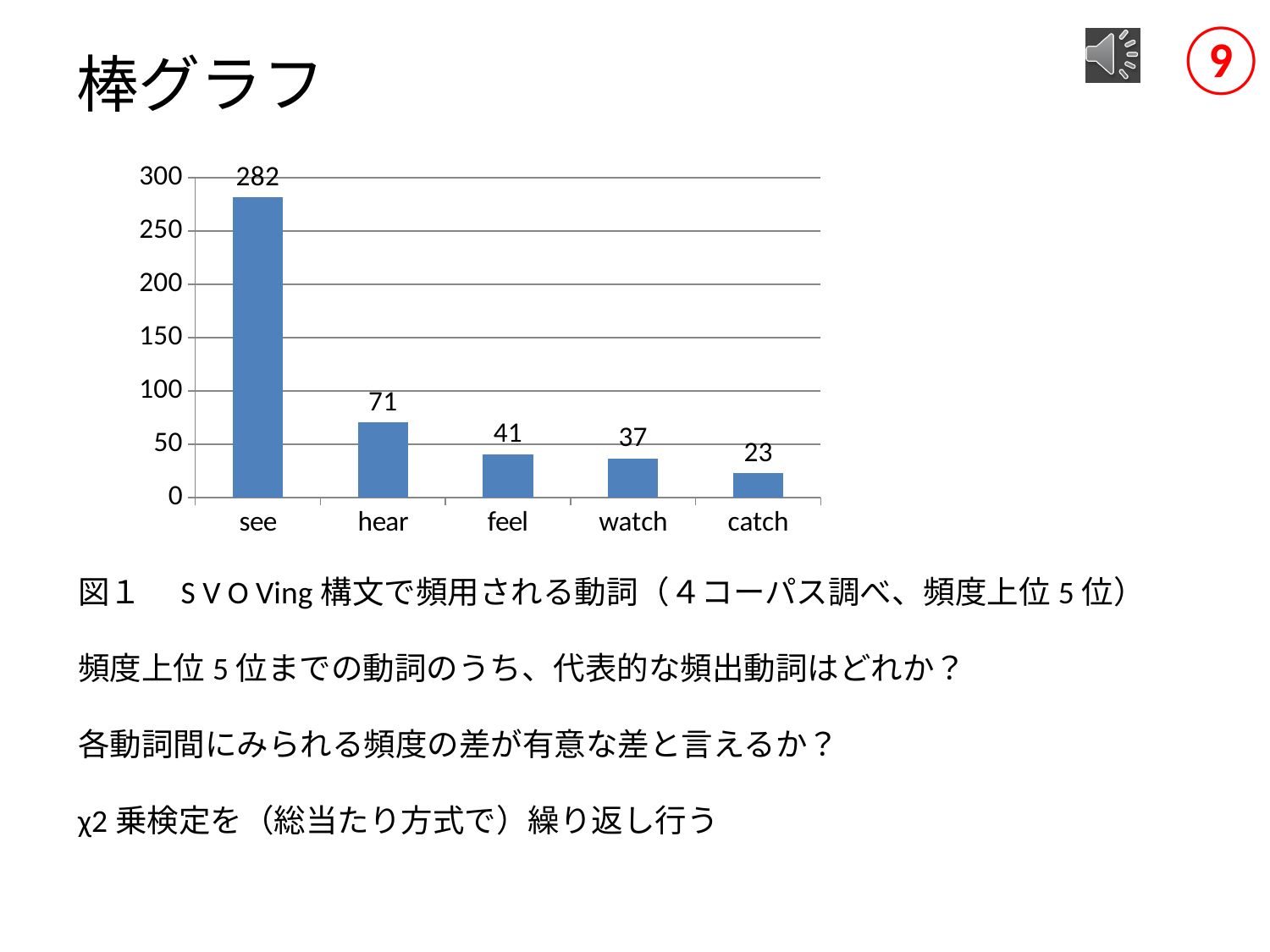
What is the value for feel? 41 What is the value for see? 282 Which verb has the lowest value? catch What kind of chart is shown on the slide? bar chart What is the value for catch? 23 Which verb has the highest value? see How many verbs are shown on the x axis? 5 What is the value for hear? 71 Which is larger, the value for hear or the value for watch? hear Do the values rise or fall from see to catch along the x axis? fall What is the difference between the values for see and hear? 211 What is the difference between the values for feel and watch? 4